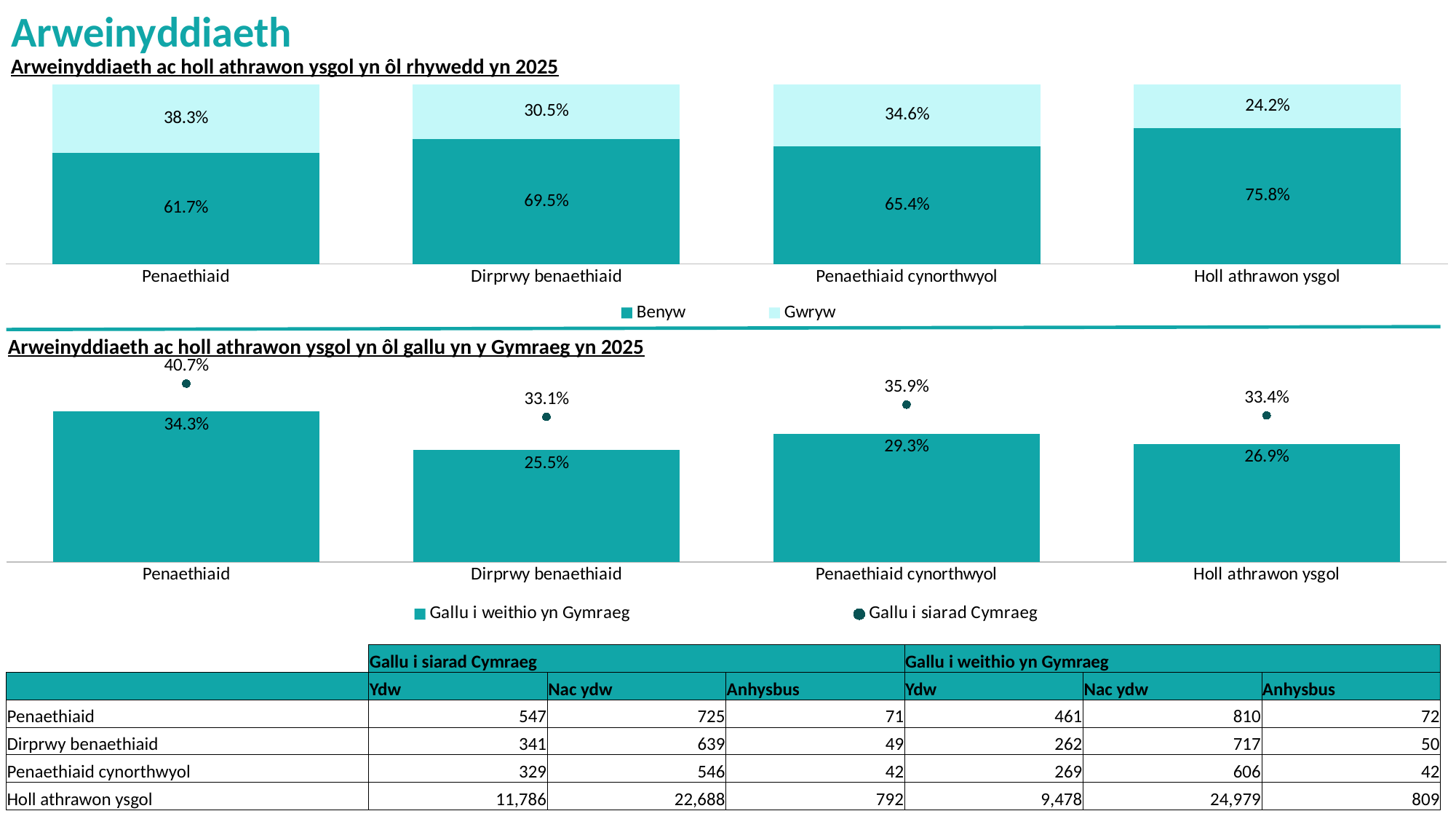
In the top chart (by rhywedd), what is the Gwryw value for Holl athrawon ysgol? 24.2% In the top chart (by rhywedd), which category has the lowest Gwryw share? Holl athrawon ysgol In the bottom chart (Arweinyddiaeth ac holl athrawon ysgol yn ôl gallu yn y Gymraeg yn 2025), what is the Gallu i siarad Cymraeg value for Penaethiaid? 40.7% In the top chart (by rhywedd), how many series does the legend list? 2 In the top chart (Arweinyddiaeth ac holl athrawon ysgol yn ôl rhywedd yn 2025), what is the Benyw value for Penaethiaid? 61.7% In the top chart (by rhywedd), what is the difference between the Benyw and Gwryw values for Dirprwy benaethiaid? 39 percentage points In the bottom chart (by gallu yn y Gymraeg), is the Gallu i siarad Cymraeg value for Penaethiaid cynorthwyol larger or smaller than that for Holl athrawon ysgol? Larger In the bottom chart (by gallu yn y Gymraeg), what is the Gallu i weithio yn Gymraeg value for Dirprwy benaethiaid? 25.5% What type of chart is the top chart (by rhywedd)? Stacked bar chart In the top chart (by rhywedd), which category has the highest Benyw share? Holl athrawon ysgol How many categories are shown on the x axis of the bottom chart (by gallu yn y Gymraeg)? 4 In the bottom chart (by gallu yn y Gymraeg), which category has the lowest Gallu i weithio yn Gymraeg value? Dirprwy benaethiaid